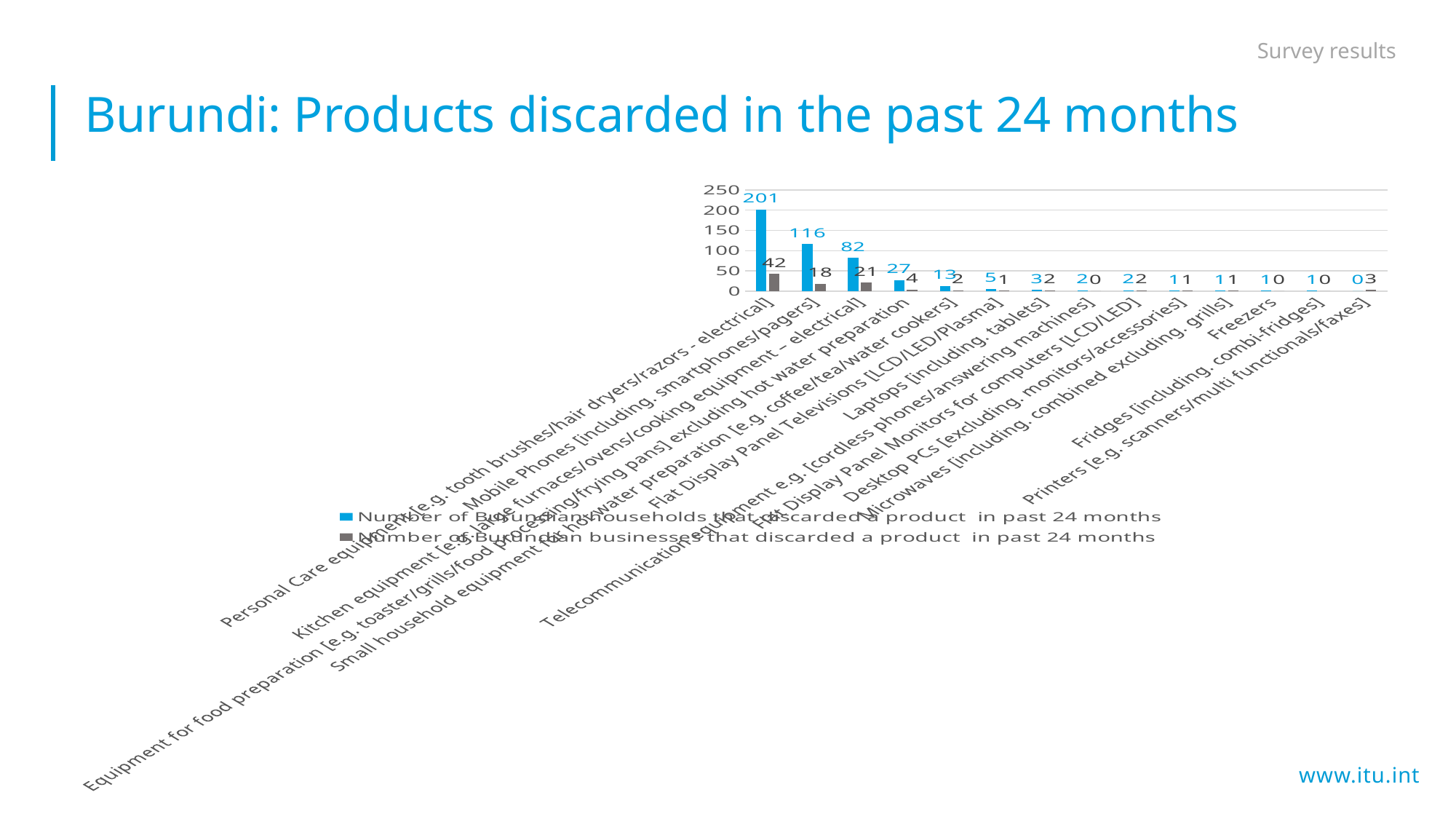
Which product category has the highest number of Burundian businesses that discarded it? Personal Care equipment [e.g. tooth brushes/hair dryers/razors - electrical] What is the difference between the number of households and the number of businesses that discarded Personal Care equipment? 159 What is the number of Burundian businesses that discarded Mobile Phones in the past 24 months? 18 How many product categories are shown on the x axis of the chart? 14 Which product category has the highest number of Burundian households that discarded it? Personal Care equipment [e.g. tooth brushes/hair dryers/razors - electrical] What is the number of Burundian households that discarded Kitchen equipment in the past 24 months? 82 How many series does the chart legend list? 2 What is the number of Burundian businesses that discarded Printers in the past 24 months? 3 What is the difference between the number of households that discarded Mobile Phones and the number that discarded Kitchen equipment? 34 What is the number of Burundian households that discarded Personal Care equipment in the past 24 months? 201 Which is larger: the number of businesses that discarded Kitchen equipment or the number of businesses that discarded Mobile Phones? Kitchen equipment What kind of chart is shown on the slide? Bar chart